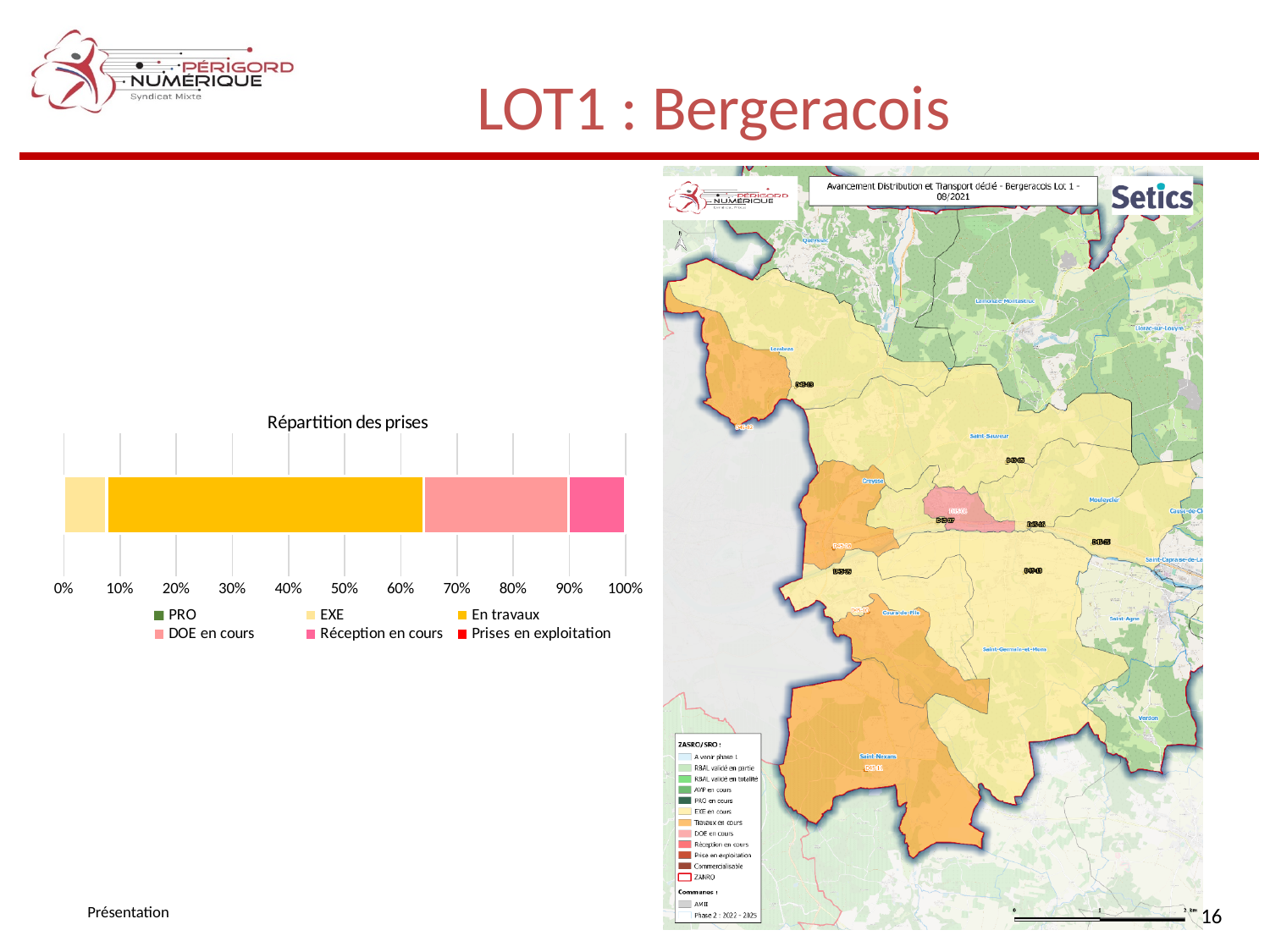
Is the share for 'En travaux' greater or less than 50%? greater Is the share for 'EXE' greater or less than 10%? less Which is larger in the chart, the share for 'En travaux' or the share for 'DOE en cours'? En travaux What is the maximum value shown on the x axis of the chart? 100% What is the title of the chart on the slide? Répartition des prises How many series does the chart legend list? 6 Which series occupies the largest share of the bar in the 'Répartition des prises' chart? En travaux What kind of chart is shown on the slide? Stacked bar chart Is the share for 'Réception en cours' greater or less than 20%? less Which is larger in the chart, the share for 'EXE' or the share for 'DOE en cours'? DOE en cours How many coloured segments are visible in the stacked bar? 4